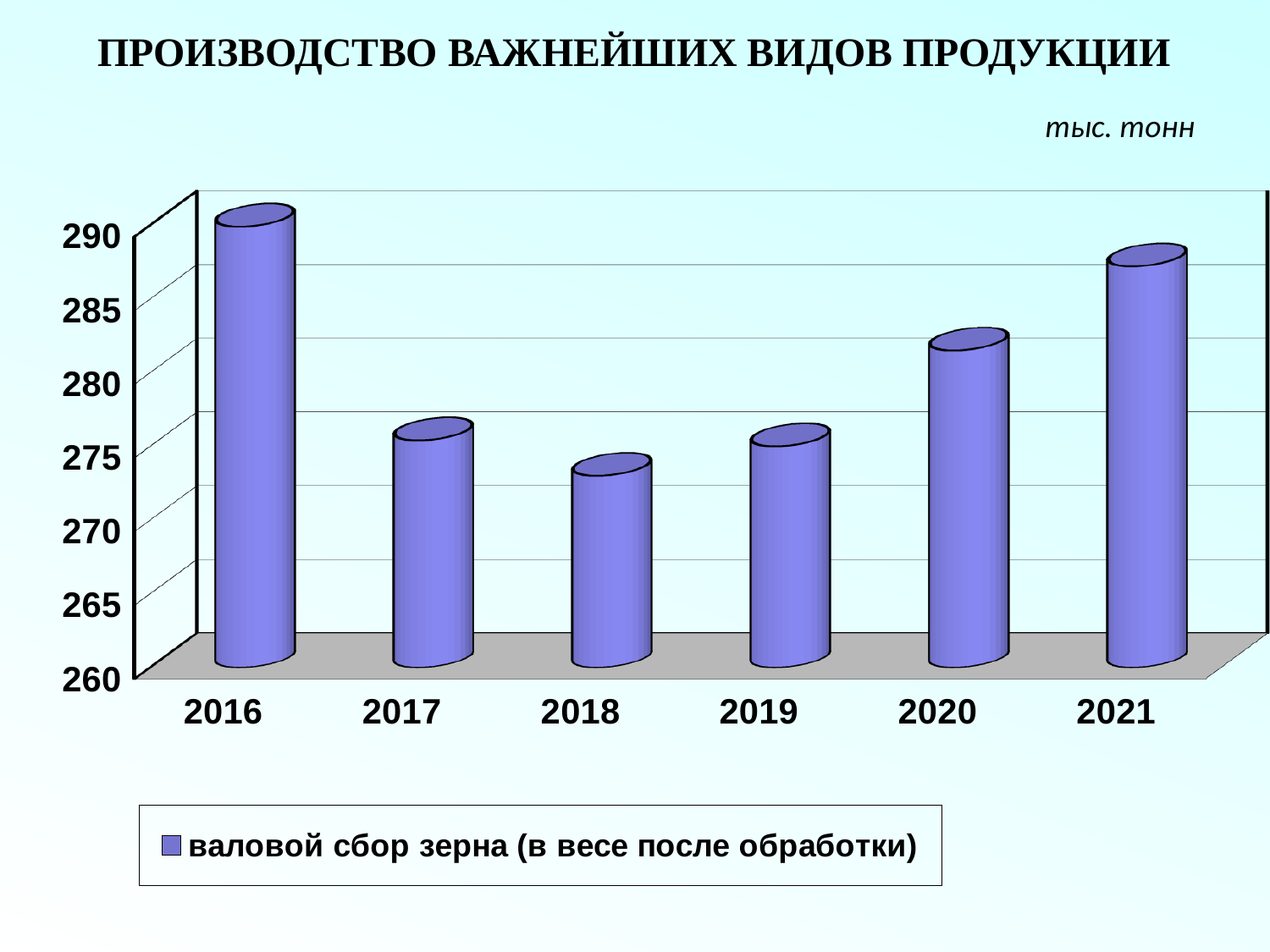
Is the value for 2016 greater or less than 285? greater Is the value for 2020 greater or less than 280? greater Which year has the lowest value in the chart? 2018 Which year has the highest value in the chart? 2016 What kind of chart is shown on the slide? bar chart What unit of measurement is indicated above the chart? тыс. тонн How many series does the legend list? 1 Which is larger, the value for 2016 or the value for 2021? 2016 Is the value for 2021 greater or less than 285? greater How many years are shown on the x axis of the chart? 6 Do the values rise or fall from 2018 to 2021? rise